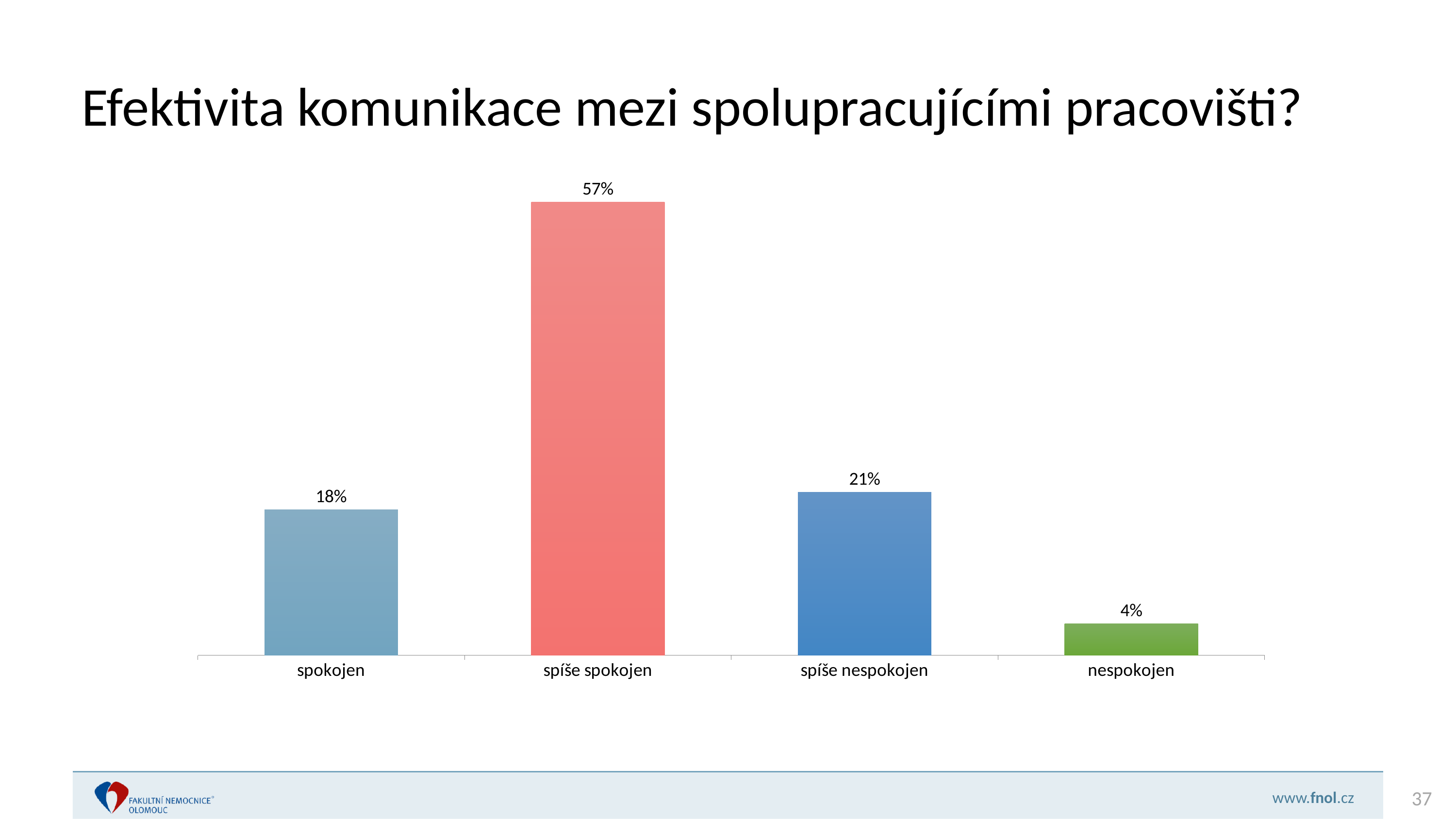
What is the value for "spokojen"? 18% What is the difference between the values for "spíše spokojen" and "spíše nespokojen"? 36% What is the difference between the values for "spokojen" and "nespokojen"? 14% Which category has the lowest value? nespokojen How many categories are shown on the x axis? 4 What is the value for "spíše nespokojen"? 21% What is the value for "nespokojen"? 4% What kind of chart is shown on the slide? bar chart What colour is the bar for "spíše spokojen"? red What is the value for "spíše spokojen"? 57% Which is larger, the value for "spokojen" or the value for "spíše nespokojen"? spíše nespokojen Which category has the highest value? spíše spokojen